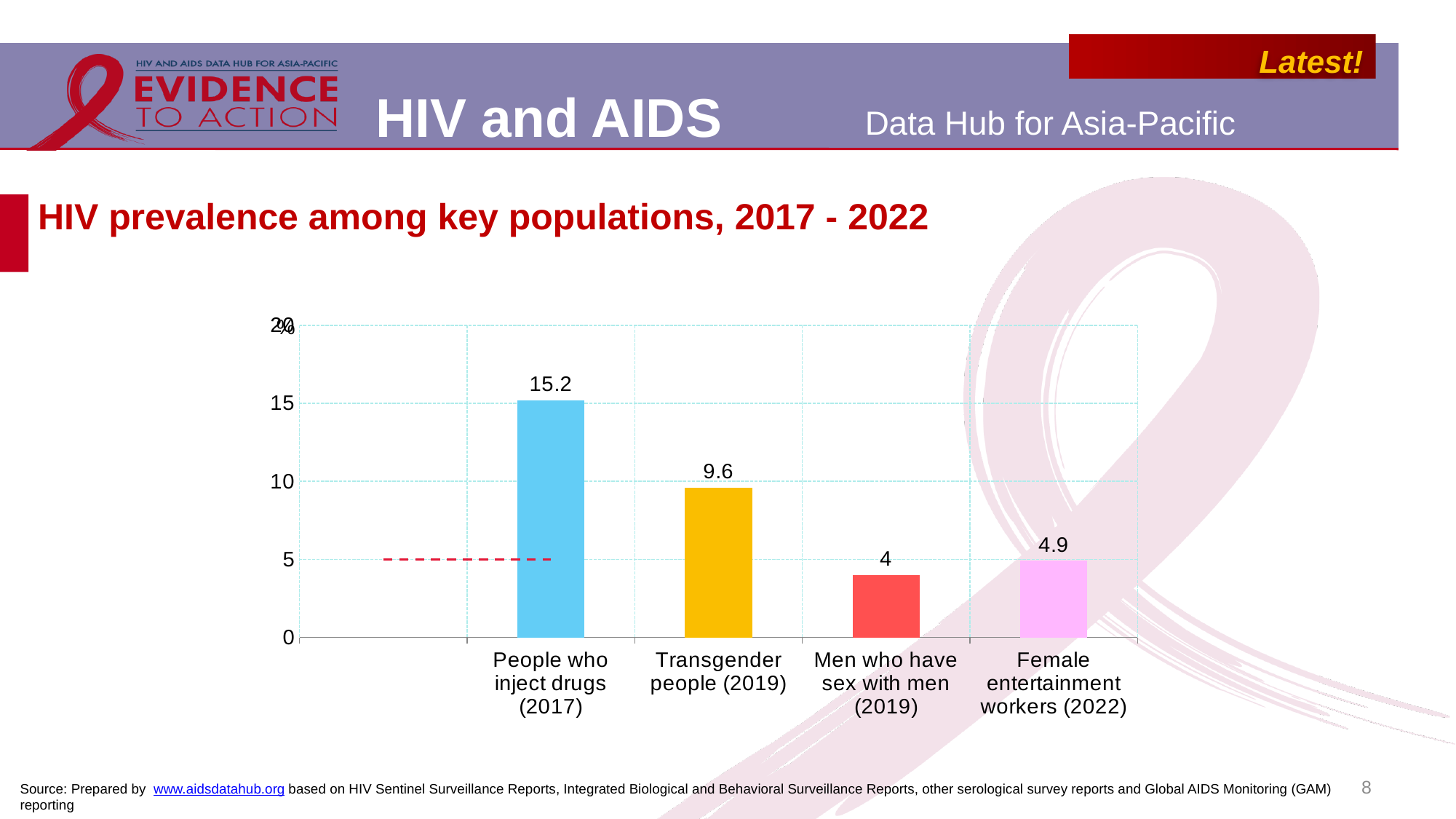
Which key population has the highest HIV prevalence in the chart? People who inject drugs (2017) What kind of chart is used on this slide? Bar chart What is the title of the chart on this slide? HIV prevalence among key populations, 2017 - 2022 Which key population has the lowest HIV prevalence in the chart? Men who have sex with men (2019) Is the value for Transgender people (2019) greater or less than 10? less What is the HIV prevalence value shown for Female entertainment workers (2022)? 4.9 What is the HIV prevalence value shown for People who inject drugs (2017)? 15.2 How many key population categories are shown in the chart? 4 What is the difference between the values for People who inject drugs (2017) and Transgender people (2019)? 5.6 What is the HIV prevalence value shown for Men who have sex with men (2019)? 4 Which is larger: the value for Female entertainment workers (2022) or Men who have sex with men (2019)? Female entertainment workers (2022) What is the HIV prevalence value shown for Transgender people (2019)? 9.6